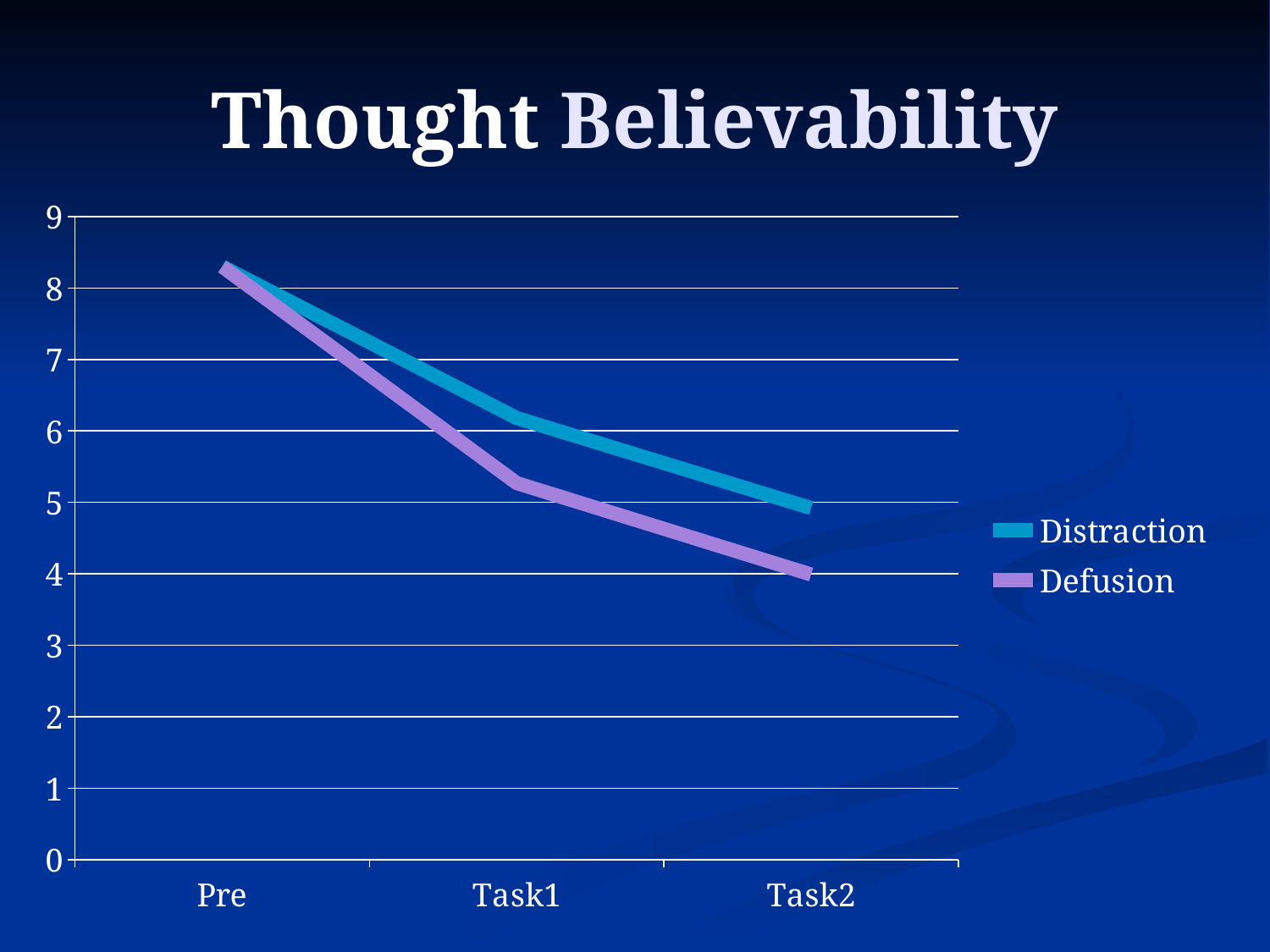
Is the value for Defusion at Task1 greater or less than 6? less Do the values for Defusion rise or fall from Pre to Task2? fall Do the values for Distraction rise or fall from Pre to Task2? fall Is the value for Distraction at Task2 greater or less than 4? greater What kind of chart is shown on the slide? line chart At Task2, which series has the lower value, Distraction or Defusion? Defusion How many series does the legend list? 2 What is the title of the chart? Thought Believability Is the value for Distraction at Pre greater or less than 7? greater At Task1, which series has the higher value, Distraction or Defusion? Distraction How many points are there along the x axis? 3 Which series is drawn in purple? Defusion